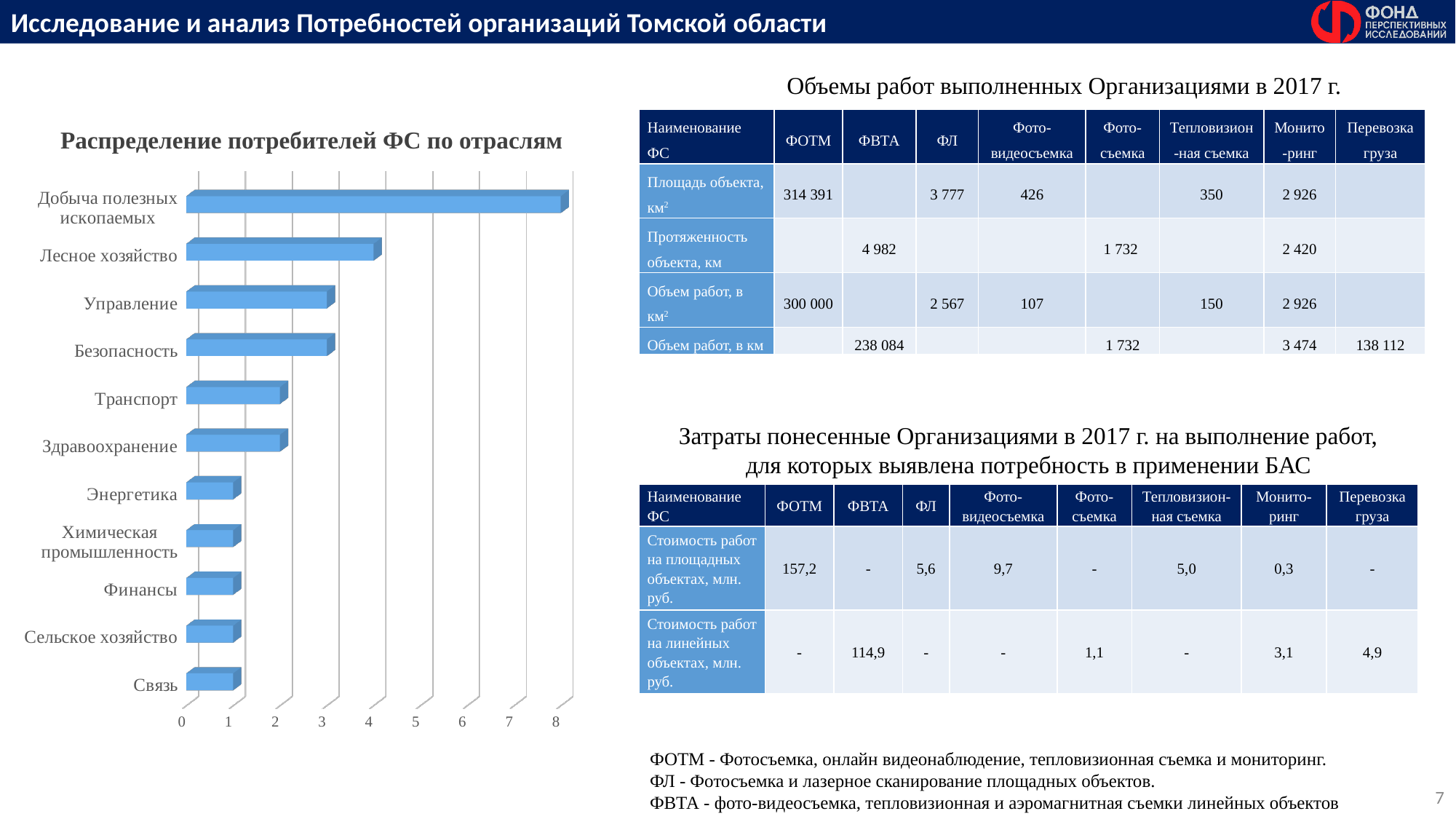
What is the title of the bar chart on the left side of the slide? Распределение потребителей ФС по отраслям How many categories (industries) are shown in the chart "Распределение потребителей ФС по отраслям"? 11 In the chart "Распределение потребителей ФС по отраслям", are the bars ordered from largest to smallest going from top to bottom? yes In the chart "Распределение потребителей ФС по отраслям", is the value for Транспорт greater or less than 3? less In the chart "Распределение потребителей ФС по отраслям", which has the larger value: Транспорт or Энергетика? Транспорт What kind of chart is "Распределение потребителей ФС по отраслям"? bar chart In the chart "Распределение потребителей ФС по отраслям", is the value for Лесное хозяйство greater or less than 3? greater In the chart "Распределение потребителей ФС по отраслям", which has the larger value: Лесное хозяйство or Управление? Лесное хозяйство In the chart "Распределение потребителей ФС по отраслям", which industry has the highest value? Добыча полезных ископаемых In the chart "Распределение потребителей ФС по отраслям", is the value for Связь greater or less than 2? less